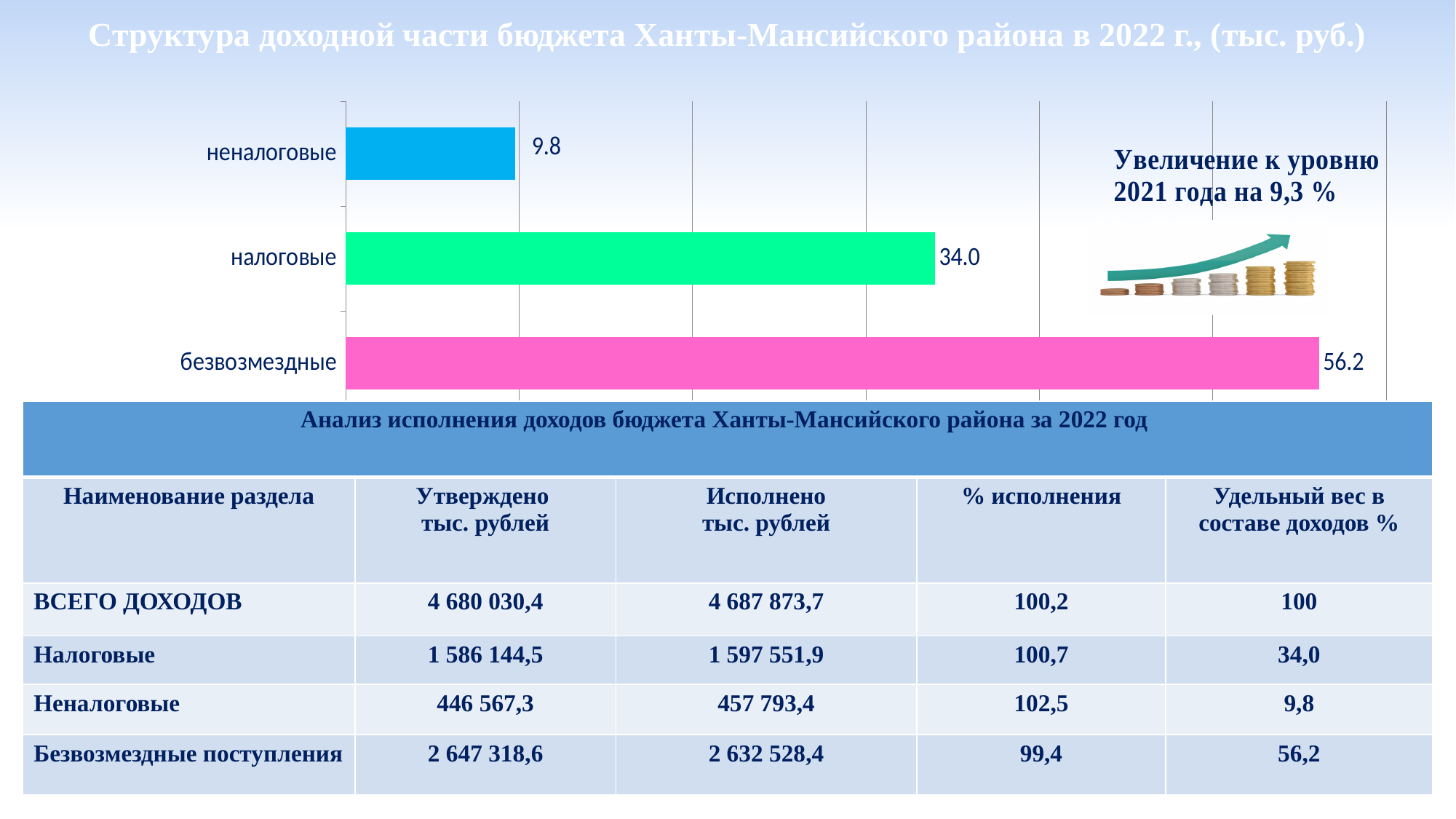
What colour is the bar for безвозмездные in the chart? pink Which is larger in the bar chart, the value for налоговые or the value for неналоговые? налоговые What colour is the bar for налоговые in the chart? green What is the difference between the values for налоговые and неналоговые in the bar chart? 24.2 What type of chart is shown on the slide? bar chart Which category has the lowest value in the bar chart? неналоговые How many categories are shown in the bar chart? 3 What is the value shown for безвозмездные in the bar chart? 56.2 What is the difference between the values for безвозмездные and налоговые in the bar chart? 22.2 What is the value shown for неналоговые in the bar chart? 9.8 Which category has the highest value in the bar chart? безвозмездные What is the value shown for налоговые in the bar chart? 34.0